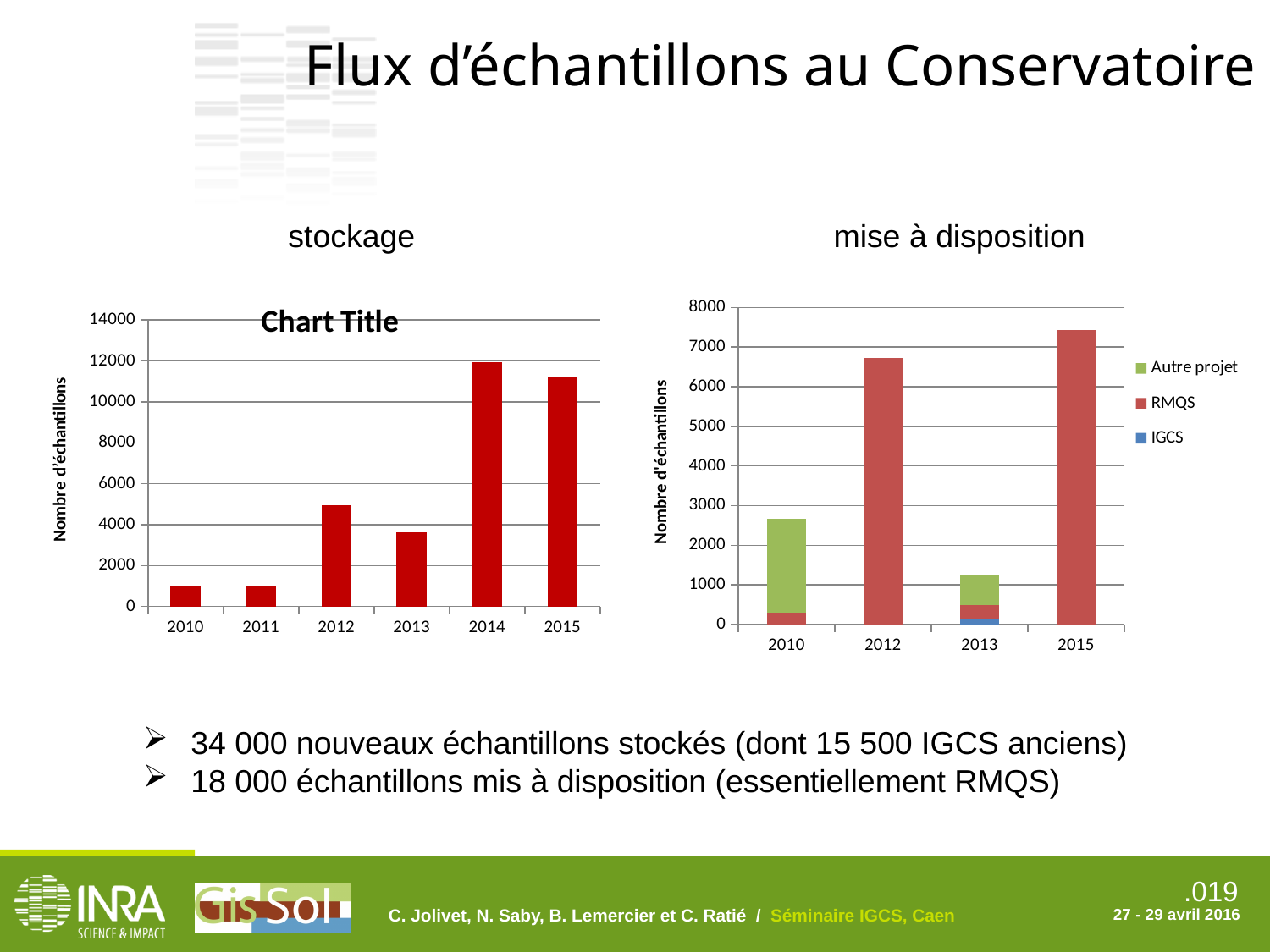
In the 'stockage' chart on the left, which year has the highest value? 2014 In the 'stockage' chart on the left, which is larger, the value for 2012 or the value for 2013? 2012 In the 'stockage' chart on the left, is the value for 2014 greater or less than 10000? greater In the 'mise à disposition' chart on the right, is the total for 2012 greater or less than 6000? greater How many series does the legend of the 'mise à disposition' chart on the right list? 3 In the 'mise à disposition' chart on the right, which year has the tallest stacked bar? 2015 In the 'mise à disposition' chart on the right, which year has the shortest stacked bar? 2013 In the 'stockage' chart on the left, is the value for 2010 greater or less than 2000? less What title is printed on the 'stockage' chart on the left? Chart Title How many years are shown on the x axis of the 'stockage' chart on the left? 6 What kind of chart is the 'stockage' chart on the left? bar chart